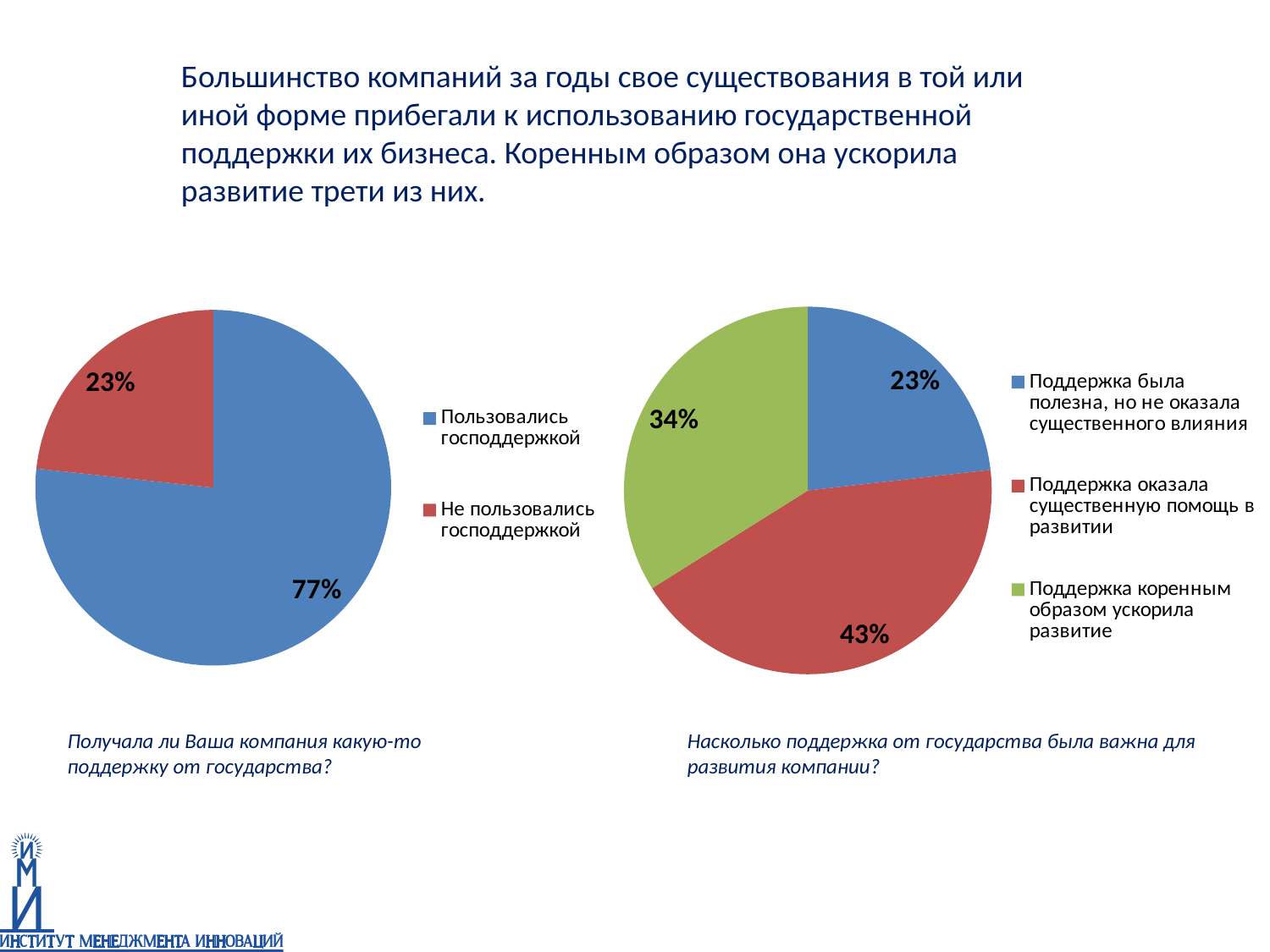
In the right pie chart, which category has the smallest share? Поддержка была полезна, но не оказала существенного влияния In the left pie chart, which category has the largest share? Пользовались господдержкой In the left pie chart, what share of companies did not use state support (Не пользовались господдержкой)? 23% In the right pie chart, what share says support fundamentally accelerated development (Поддержка коренным образом ускорила развитие)? 34% How many categories does the legend of the right pie chart list? 3 In the right pie chart, what colour is the slice for 'Поддержка коренным образом ускорила развитие'? Green In the right pie chart, which is larger: the share for 'Поддержка оказала существенную помощь в развитии' or for 'Поддержка коренным образом ускорила развитие'? Поддержка оказала существенную помощь в развитии In the right pie chart, what share says support provided significant help in development (Поддержка оказала существенную помощь в развитии)? 43% In the left pie chart, what share of companies used state support (Пользовались господдержкой)? 77% In the right pie chart, what share says support was useful but had no significant influence? 23% What type of chart is the left chart? Pie chart In the left pie chart, what is the difference in percentage points between the two slices? 54